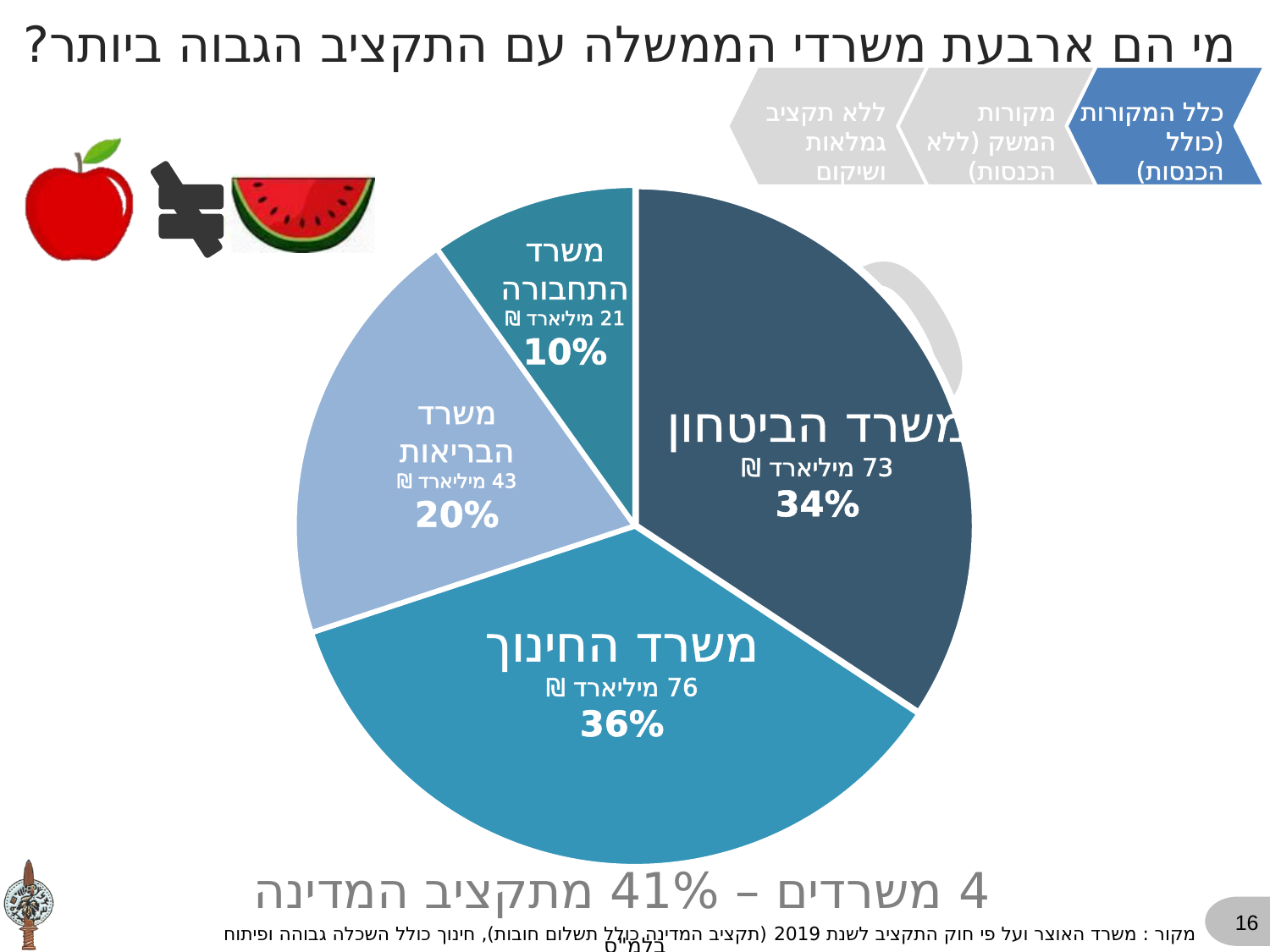
What value in billions of ₪ is shown for משרד התחבורה? 21 מיליארד ₪ How many slices does the pie chart have? 4 What percentage share is shown for משרד החינוך? 36% What value in billions of ₪ is shown for משרד הביטחון? 73 מיליארד ₪ Which ministry has the largest slice of the pie chart? משרד החינוך What is the title of the slide containing the pie chart? מי הם ארבעת משרדי הממשלה עם התקציב הגבוה ביותר? What is the difference in billions of ₪ between משרד החינוך and משרד הביטחון? 3 מיליארד ₪ What is the difference in percentage points between משרד הבריאות and משרד התחבורה? 10 What kind of chart is shown on the slide? pie chart What percentage share is shown for משרד הבריאות? 20% Which is larger, the share of משרד הבריאות or the share of משרד התחבורה? משרד הבריאות Which ministry has the smallest slice of the pie chart? משרד התחבורה